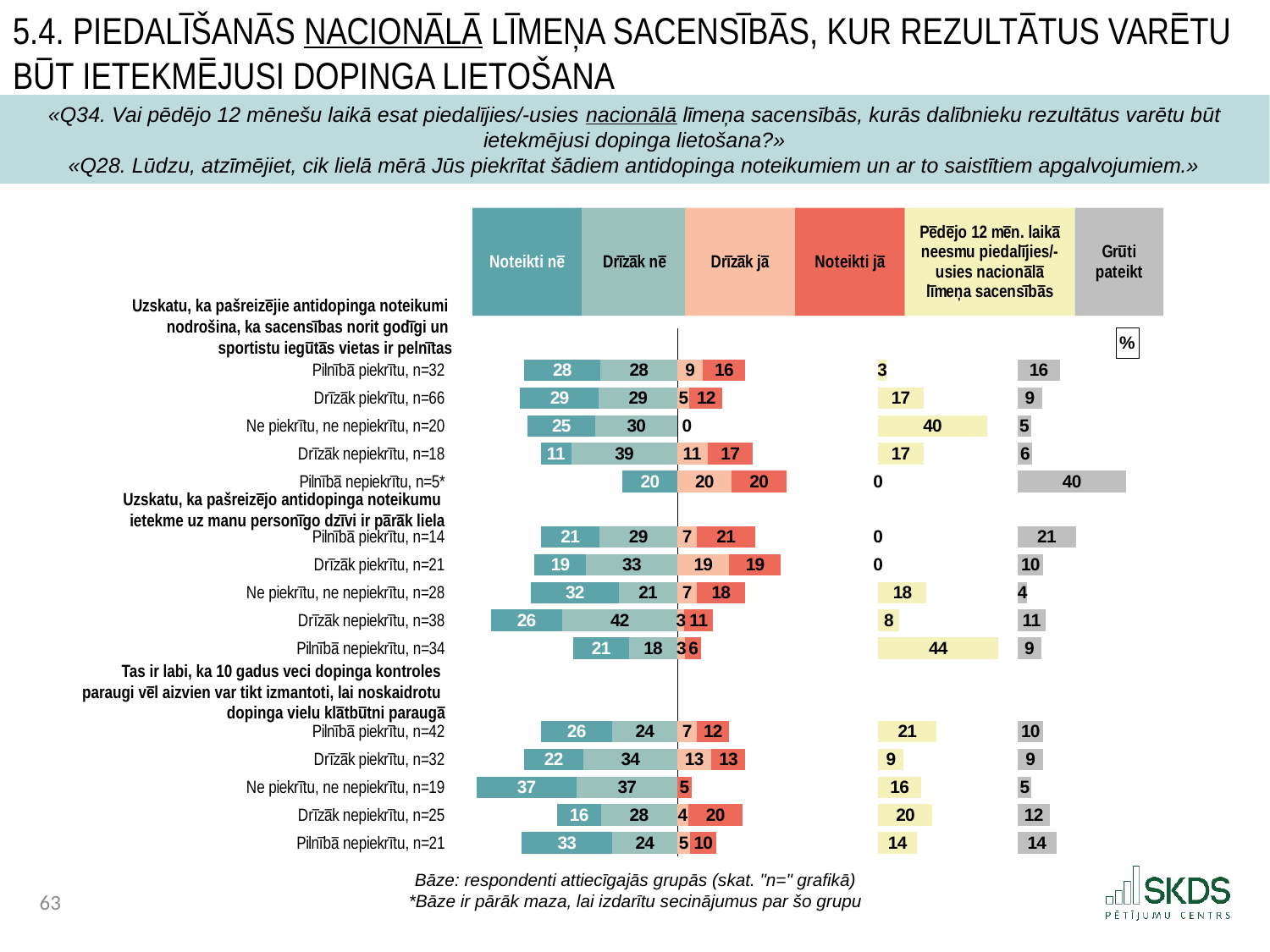
How many respondent groups (rows) are plotted in the chart? 15 How many series does the legend list? 6 What is the 'Grūti pateikt' value for 'Pilnībā nepiekrītu, n=5*' under the first statement? 40 What is the 'Pēdējo 12 mēn. laikā neesmu piedalījies/-usies nacionālā līmeņa sacensībās' value for 'Ne piekrītu, ne nepiekrītu, n=20' under the first statement? 40 Which row has the highest 'Pēdējo 12 mēn. laikā neesmu piedalījies/-usies nacionālā līmeņa sacensībās' value under the second statement (ietekme uz manu personīgo dzīvi)? Pilnībā nepiekrītu, n=34 What is the 'Noteikti nē' value for 'Ne piekrītu, ne nepiekrītu, n=19' under the third statement (10 gadus veci dopinga kontroles paraugi)? 37 Under the third statement, which is larger: the 'Drīzāk nē' value for 'Drīzāk piekrītu, n=32' or for 'Pilnībā piekrītu, n=42'? Drīzāk piekrītu, n=32 What is the 'Noteikti jā' value for 'Drīzāk piekrītu, n=21' under the second statement? 19 What is the 'Drīzāk nē' value for 'Drīzāk nepiekrītu, n=38' under the second statement (ietekme uz manu personīgo dzīvi ir pārāk liela)? 42 What is the difference between the 'Noteikti nē' values for 'Pilnībā nepiekrītu, n=21' and 'Drīzāk nepiekrītu, n=25' under the third statement? 17 What is the 'Noteikti nē' value for 'Pilnībā piekrītu, n=32' under the first statement (antidopinga noteikumi nodrošina, ka sacensības norit godīgi)? 28 What kind of chart is shown on the slide? bar chart